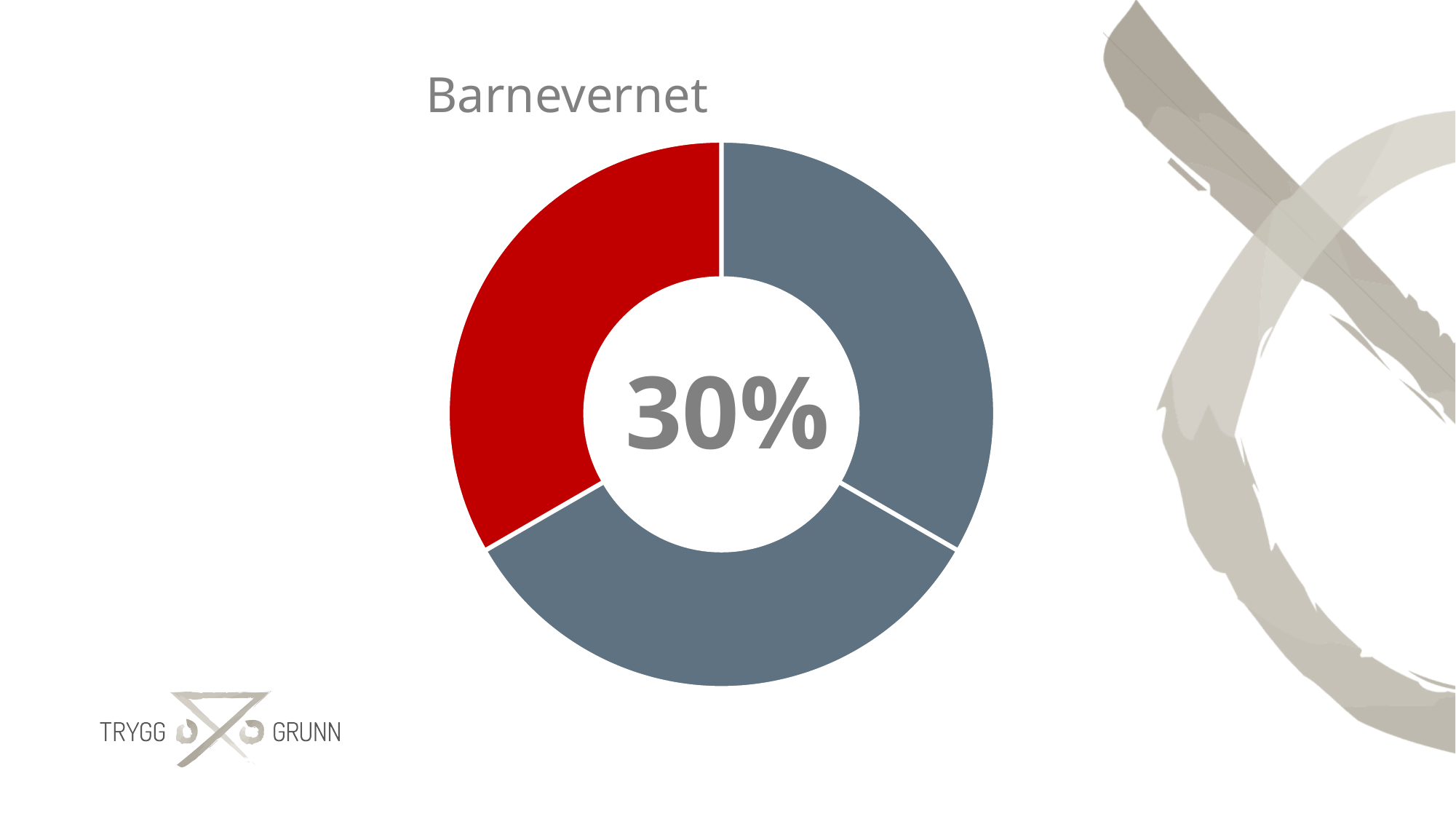
How many slices does the doughnut chart have? 3 Is the red slice's share of the chart greater or less than 50%? less What kind of chart is shown on the slide? Doughnut (pie) chart Is the red slice larger or smaller than the two grey-blue slices combined? Smaller What is the title of the chart on the slide? Barnevernet What colour is the slice that the 30% label refers to? Red What percentage is printed in the centre of the doughnut chart? 30%